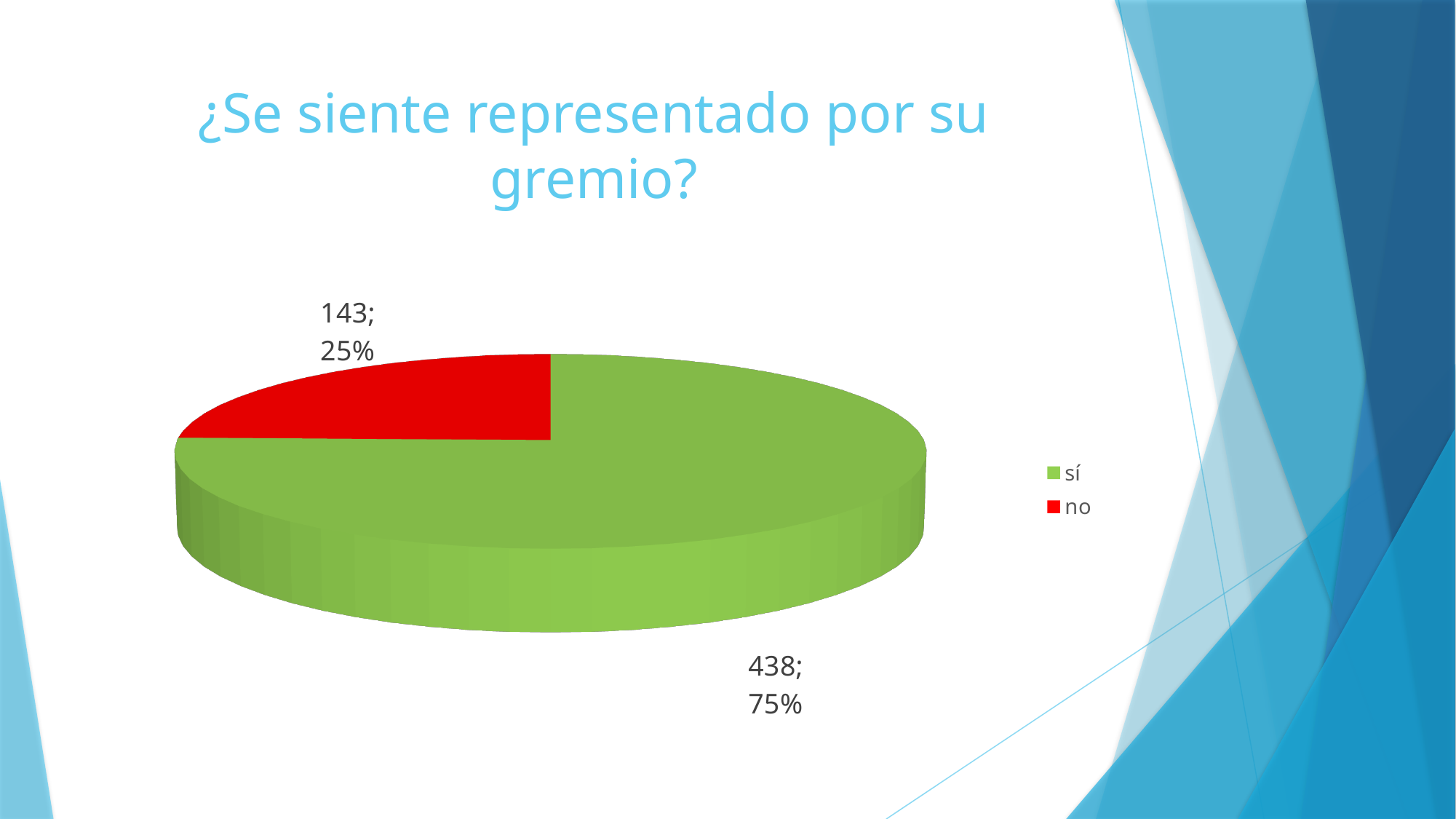
How many respondents answered "no"? 143 What percentage of the pie does the "no" slice represent? 25% What is the total number of responses shown in the pie chart? 581 Which is larger, the "sí" count or the "no" count? sí What colour is the "no" slice? red What percentage of the pie does the "sí" slice represent? 75% How many categories does the pie chart have? 2 How many respondents answered "sí"? 438 What kind of chart is shown on the slide? pie chart What is the difference between the number of "sí" and "no" responses? 295 Which category has the largest slice? sí Which category has the smallest slice? no